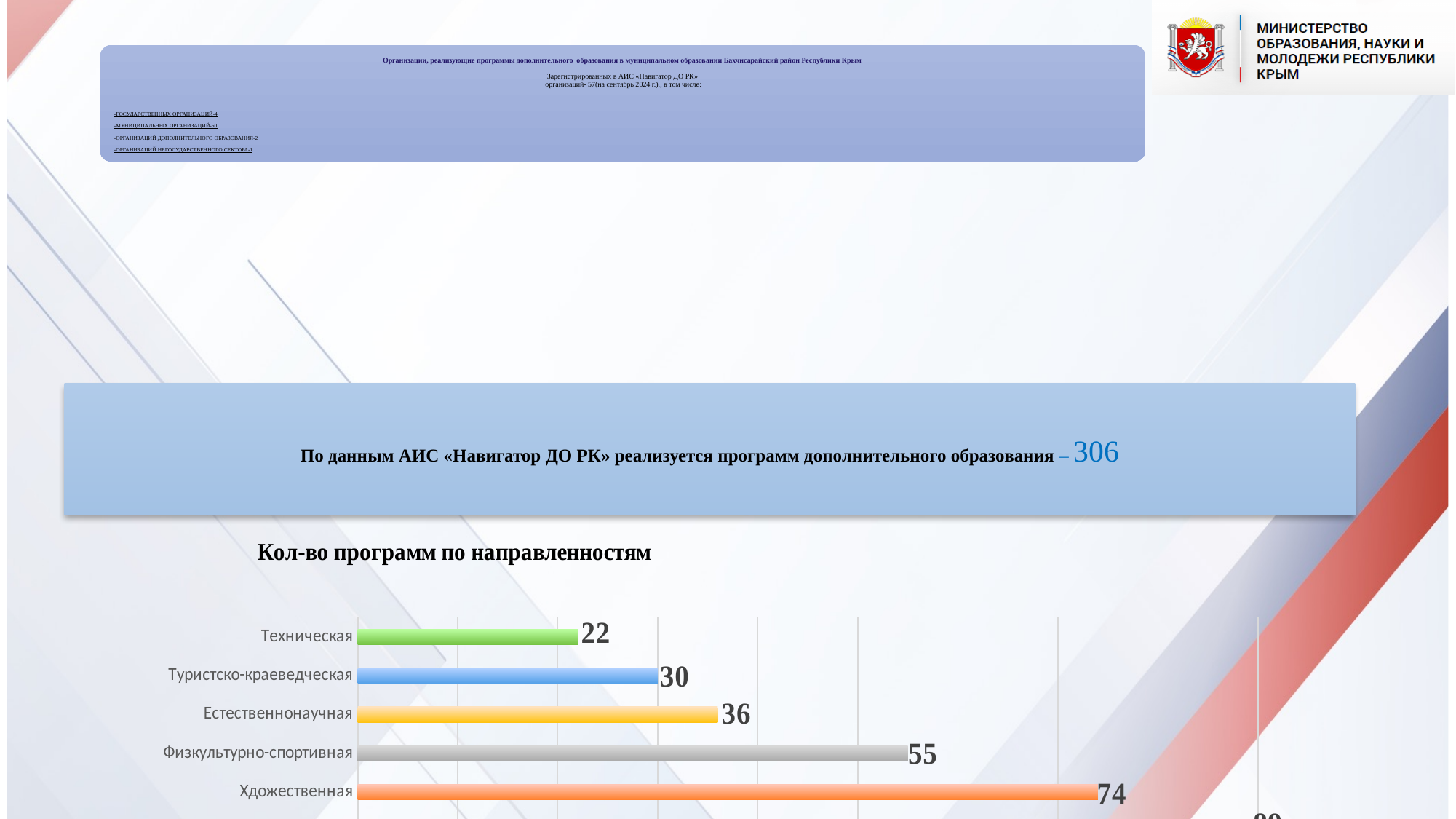
What is the value for Техническая in the chart "Кол-во программ по направленностям"? 22 What is the value for Туристско-краеведческая in the chart? 30 What is the title of the bar chart on the slide? Кол-во программ по направленностям Which is larger, the value for Туристско-краеведческая or the value for Естественнонаучная? Естественнонаучная What is the value for Художественная in the chart? 74 What is the value for Естественнонаучная in the chart? 36 What is the value for Физкультурно-спортивная in the chart? 55 Which category has the lowest value in the chart "Кол-во программ по направленностям"? Техническая What type of chart is shown under the title "Кол-во программ по направленностям"? bar chart What is the difference between the values for Художественная and Физкультурно-спортивная? 19 What is the difference between the values for Естественнонаучная and Техническая? 14 What colour is the bar for Художественная? orange